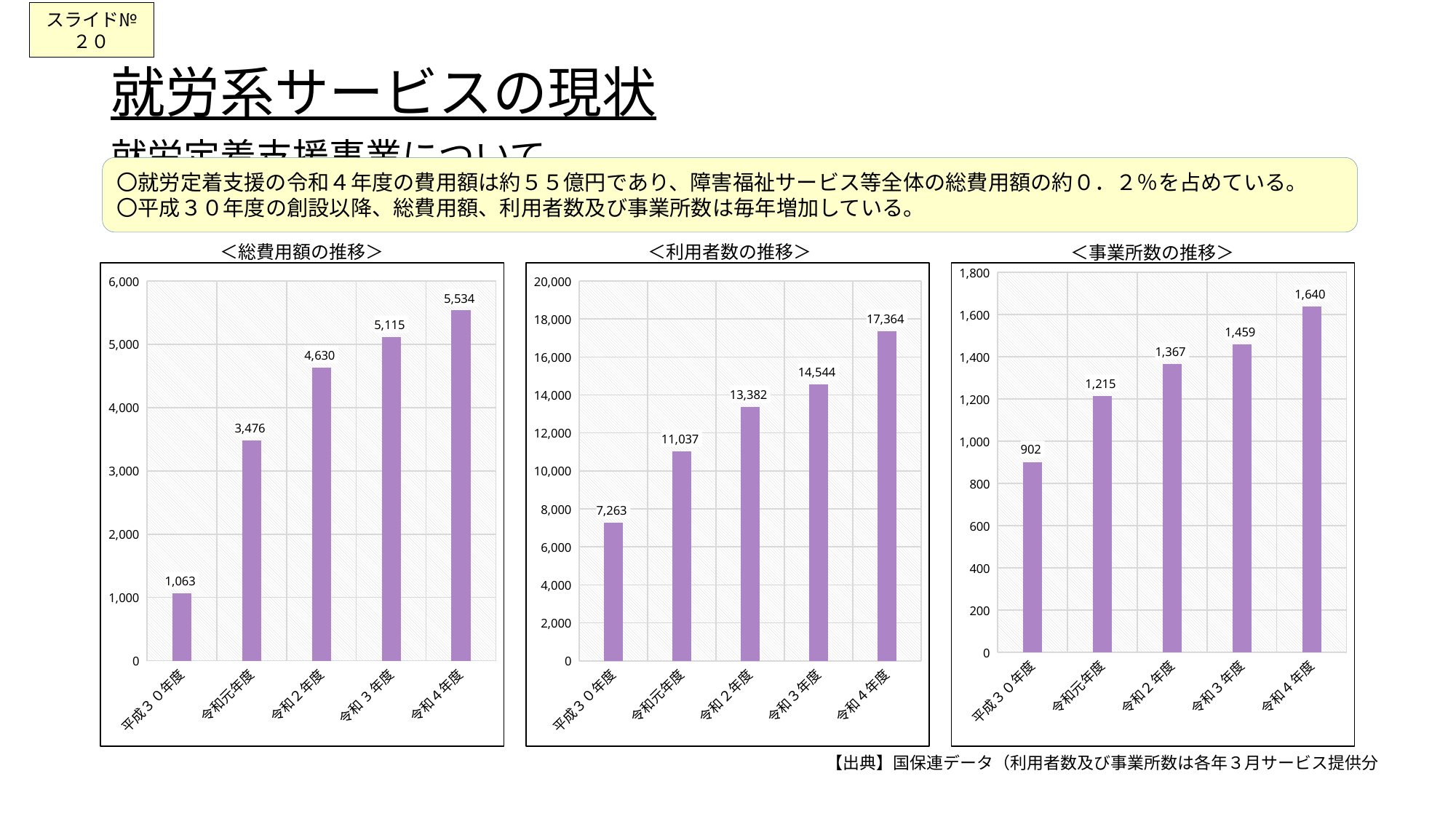
In the ＜総費用額の推移＞ chart, what is the value for 令和４年度? 5,534 In the ＜事業所数の推移＞ chart, is the value for 平成３０年度 greater or less than 1,000? less In the ＜利用者数の推移＞ chart, what is the value for 令和元年度? 11,037 In the ＜事業所数の推移＞ chart, what is the value for 令和２年度? 1,367 In the ＜事業所数の推移＞ chart, do the values rise or fall from 平成３０年度 to 令和４年度? rise In the ＜総費用額の推移＞ chart, which year has the lowest value? 平成３０年度 In the ＜総費用額の推移＞ chart, what is the difference between 令和４年度 and 令和３年度? 419 What kind of chart is the ＜総費用額の推移＞ chart? bar chart In the ＜利用者数の推移＞ chart, which year has the highest value? 令和４年度 In the ＜事業所数の推移＞ chart, which is larger, 令和元年度 or 令和３年度? 令和３年度 In the ＜利用者数の推移＞ chart, what is the difference between 令和２年度 and 平成３０年度? 6,119 How many years are shown in the ＜利用者数の推移＞ chart? 5